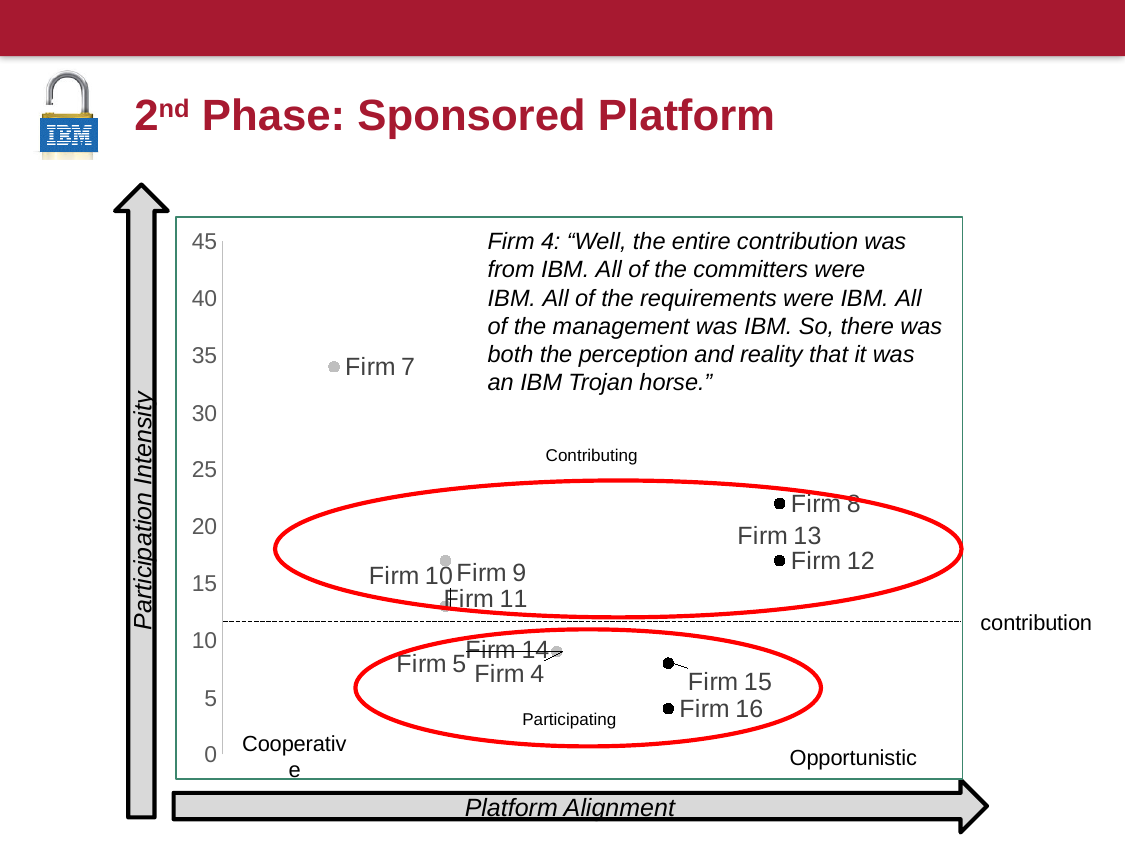
Which has a higher Participation Intensity, Firm 7 or Firm 8? Firm 7 Which firm has the highest Participation Intensity on the chart? Firm 7 Is the Participation Intensity for Firm 15 greater or less than 10? less Is the Participation Intensity for Firm 12 greater or less than 15? greater What kind of chart is shown on the slide? scatter chart Is the Participation Intensity for Firm 7 greater or less than 30? greater Which has a higher Participation Intensity, Firm 8 or Firm 12? Firm 8 What is the label of the vertical axis of the chart? Participation Intensity What is the label of the horizontal axis of the chart? Platform Alignment Which firm has the lowest Participation Intensity on the chart? Firm 16